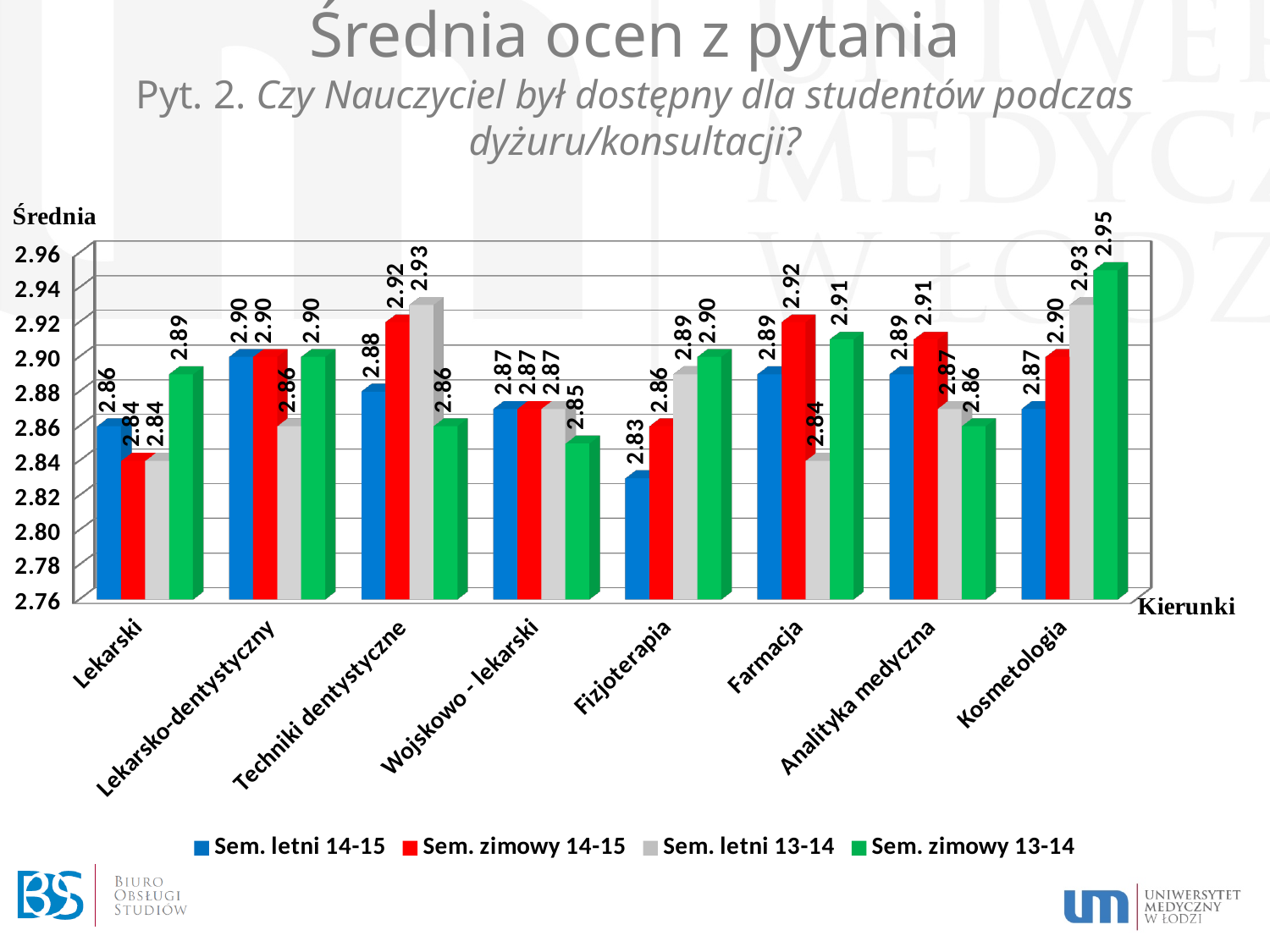
What is the difference between the Sem. zimowy 13-14 value and the Sem. letni 14-15 value for Kosmetologia? 0.08 What is the value for Kosmetologia in the Sem. zimowy 13-14 series? 2.95 What is the value for Farmacja in the Sem. zimowy 14-15 series? 2.92 Which is larger for Farmacja: the Sem. zimowy 14-15 value or the Sem. letni 13-14 value? Sem. zimowy 14-15 How many series does the legend list? 4 Which category has the lowest value in the Sem. letni 14-15 series? Fizjoterapia What is the value for Techniki dentystyczne in the Sem. letni 13-14 series? 2.93 Which colour represents the Sem. letni 13-14 series? Gray What is the value for Fizjoterapia in the Sem. letni 14-15 series? 2.83 Which category has the highest value in the Sem. zimowy 13-14 series? Kosmetologia What kind of chart is shown on the slide? Bar chart How many categories (kierunki) are shown on the x axis? 8